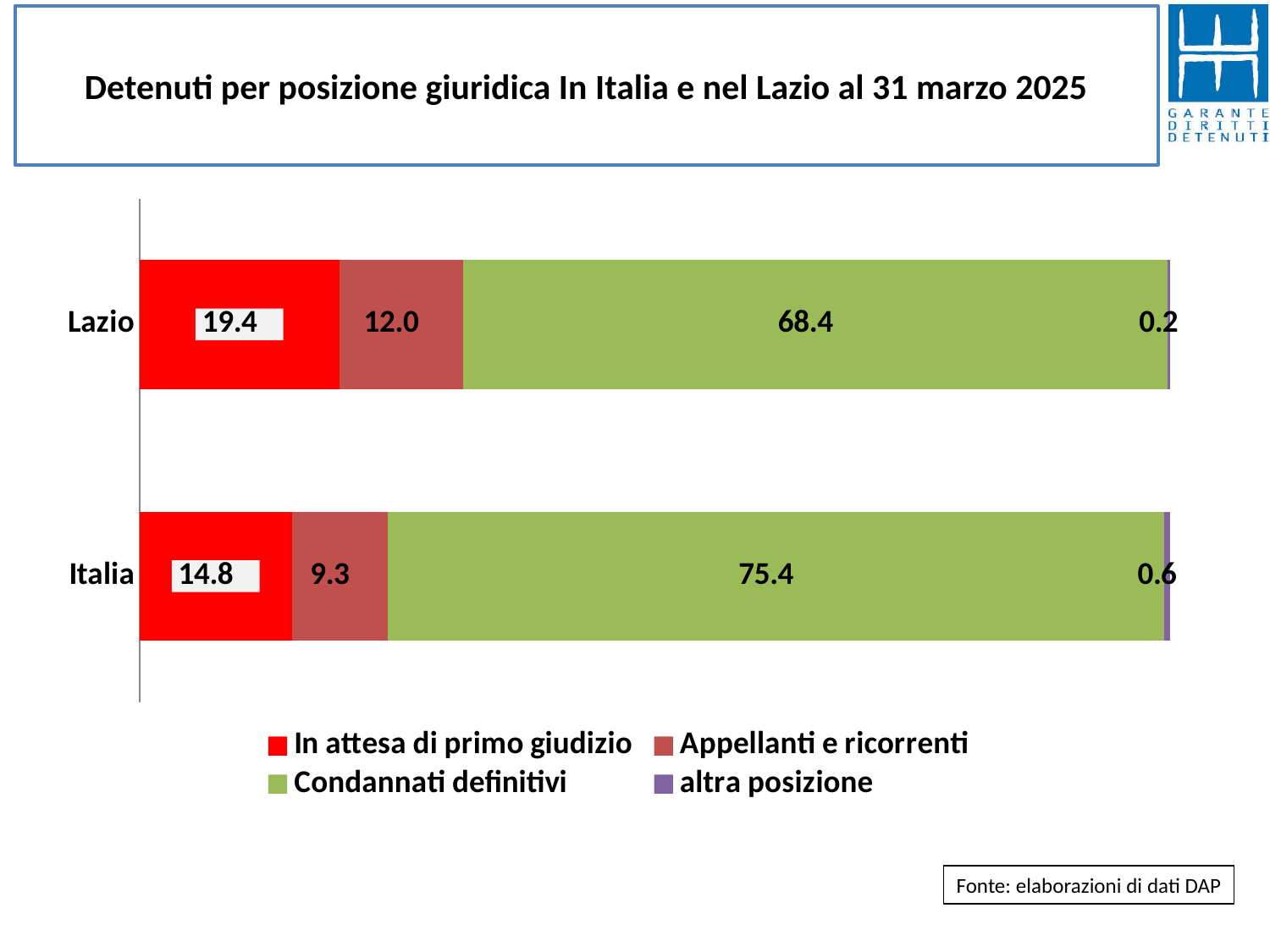
What is the difference between the 'Condannati definitivi' values for Italia and Lazio? 7.0 What is the value for 'Appellanti e ricorrenti' for Lazio? 12.0 What is the total of the stacked bar for Lazio? 100.0 What kind of chart is shown on the slide? Stacked bar chart What is the value for 'In attesa di primo giudizio' for Lazio? 19.4 Which series has the lowest value for Italia? altra posizione How many series does the legend list? 4 What is the value for 'Condannati definitivi' for Italia? 75.4 Which has the larger 'Appellanti e ricorrenti' value, Lazio or Italia? Lazio What is the value for 'altra posizione' for Italia? 0.6 Which series has the highest value for Lazio? Condannati definitivi What is the difference between the 'In attesa di primo giudizio' values for Lazio and Italia? 4.6